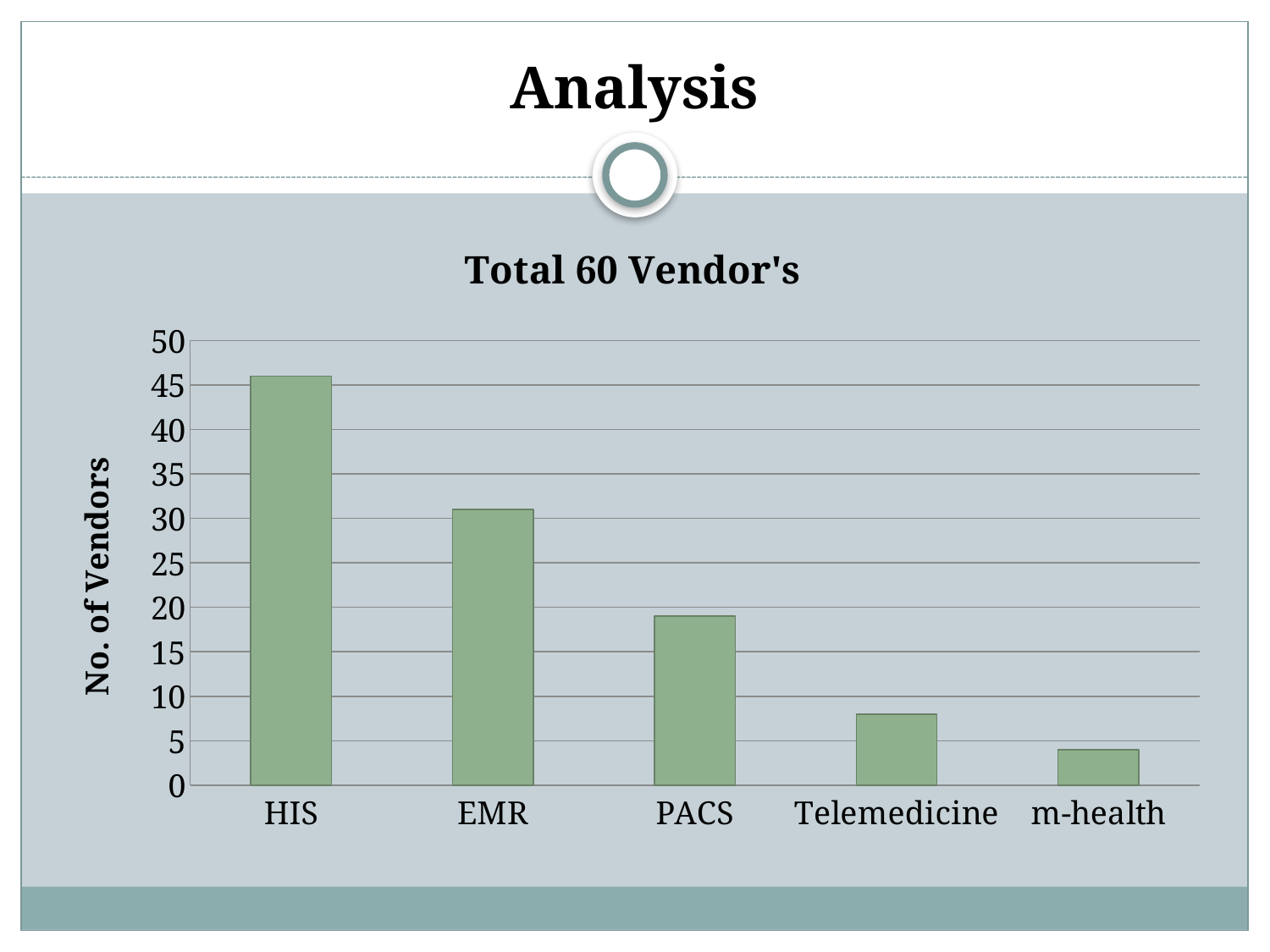
Is the value for Telemedicine greater or less than 10? less Which has more vendors, EMR or PACS? EMR What is the title of the chart? Total 60 Vendor's Is the value for HIS greater or less than 45? greater Do the values rise or fall moving from HIS to m-health along the x axis? fall Which category has the highest number of vendors? HIS Which category has the lowest number of vendors? m-health Is the value for PACS greater or less than 20? less What type of chart is shown on the slide? bar chart How many categories are shown on the x axis? 5 What is the label of the vertical axis? No. of Vendors